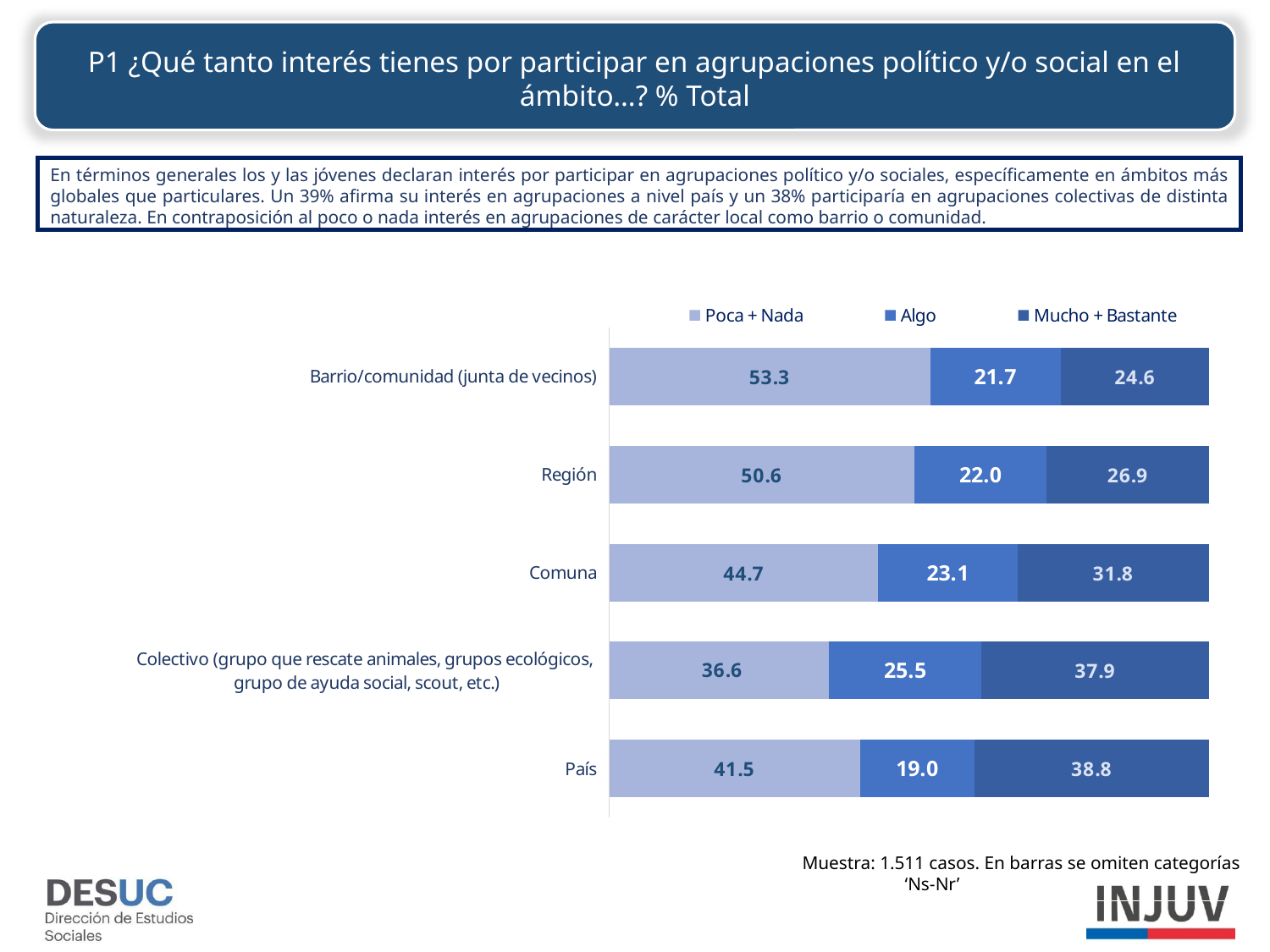
What is the difference between the 'Poca + Nada' values for Barrio/comunidad (junta de vecinos) and País? 11.8 How many series does the legend list? 3 What is the 'Mucho + Bastante' value for País? 38.8 Which is larger: the 'Mucho + Bastante' value for Comuna or for Región? Comuna What is the 'Poca + Nada' value for Barrio/comunidad (junta de vecinos)? 53.3 Which category has the highest 'Poca + Nada' value? Barrio/comunidad (junta de vecinos) What kind of chart is shown on the slide? Stacked bar chart What is the 'Algo' value for Colectivo (grupo que rescate animales, grupos ecológicos, grupo de ayuda social, scout, etc.)? 25.5 Which category has the lowest 'Algo' value? País How many categories are shown in the chart? 5 Which legend entry is shown in the lightest blue colour? Poca + Nada What is the total of the stacked bar for Colectivo (grupo que rescate animales, grupos ecológicos, grupo de ayuda social, scout, etc.)? 100.0